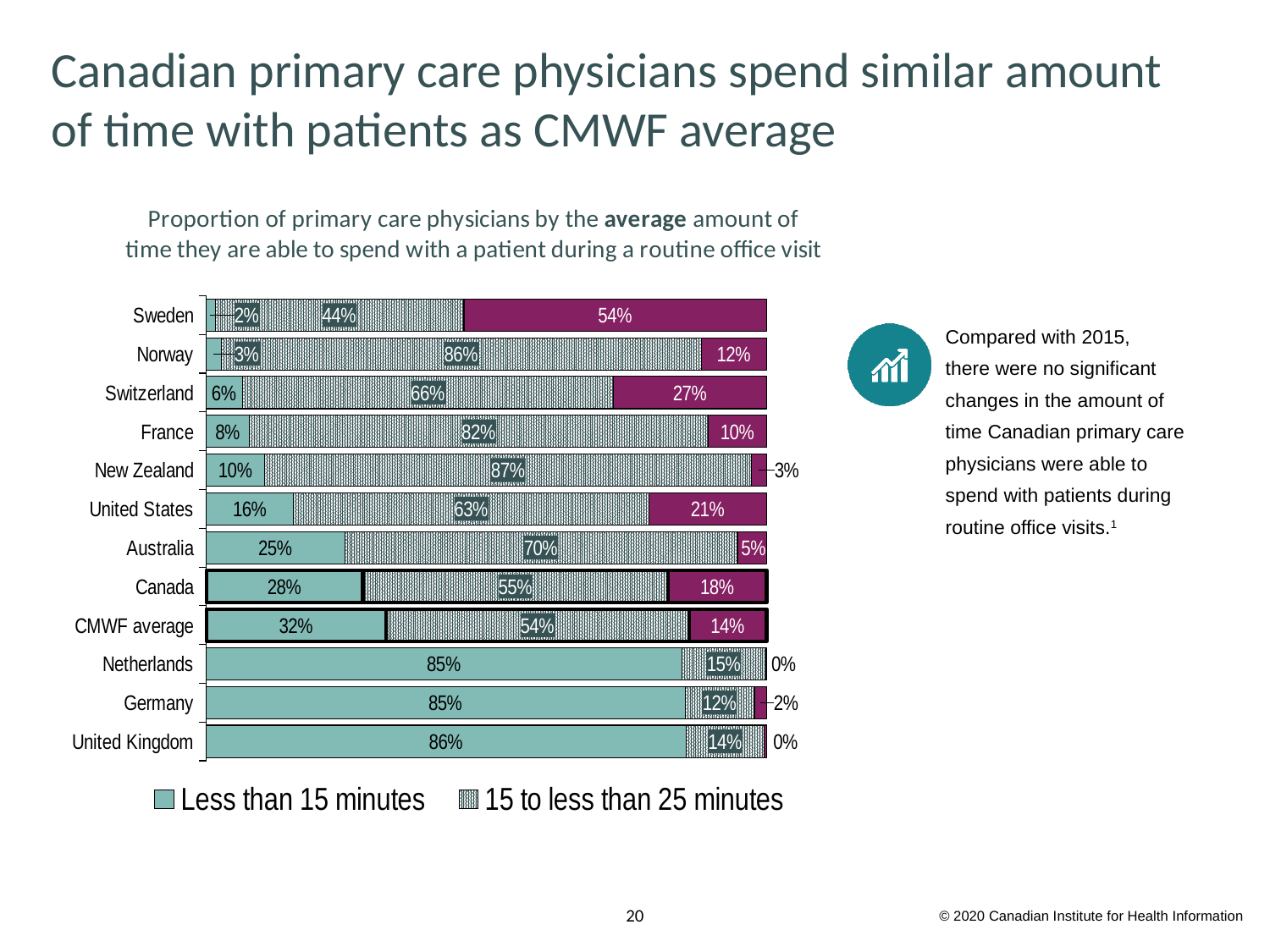
Which has a larger share of physicians spending less than 15 minutes with a patient, Australia or the United States? Australia What percentage of primary care physicians in New Zealand spend 15 to less than 25 minutes with a patient? 87% What is the value for Norway in the '15 to less than 25 minutes' series? 86% What is the value for the CMWF average in the 'Less than 15 minutes' series? 32% What are the two series named in the chart legend? Less than 15 minutes; 15 to less than 25 minutes What is the difference in percentage points between the CMWF average and Canada for the 'Less than 15 minutes' series? 4 percentage points Which country has the lowest proportion of physicians spending less than 15 minutes with a patient? Sweden How many series does the legend list? 2 How many countries or categories are shown on the chart? 12 What type of chart is shown on the slide? Stacked bar chart Which country has the highest proportion of physicians spending less than 15 minutes with a patient? United Kingdom What percentage of primary care physicians in Canada spend less than 15 minutes with a patient during a routine office visit? 28%